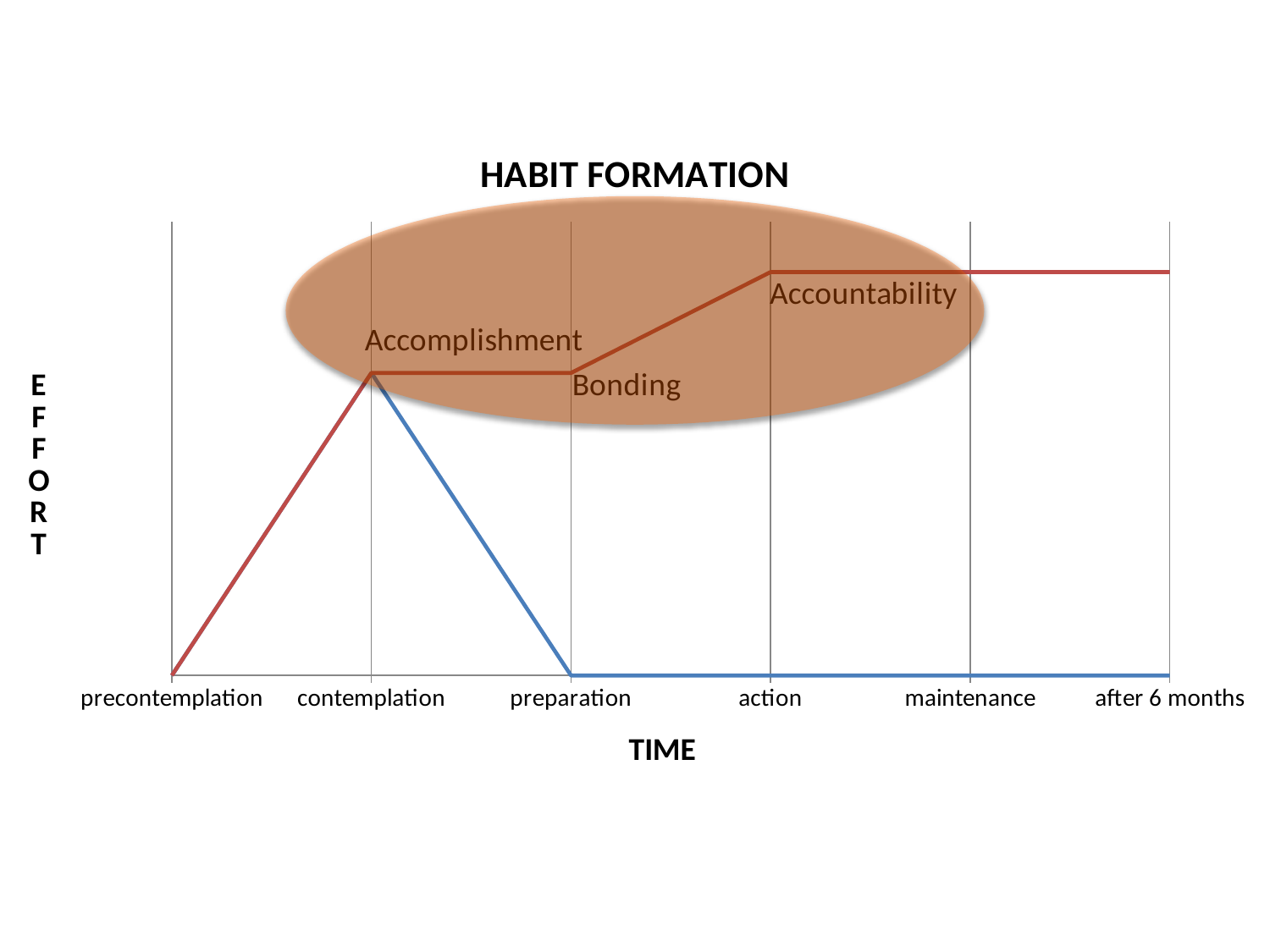
At which category is the red line at its lowest point? precontemplation How many categories are shown on the x axis? 6 At which category does the blue line reach its highest point? contemplation Which is the last category on the x axis? after 6 months Does the red line rise or fall between precontemplation and contemplation? rise How many lines are plotted on the chart? 2 What is the label of the vertical axis? EFFORT Does the red line rise or fall between preparation and action? rise At preparation, which line is higher, the red line or the blue line? red line What is the title of the chart? HABIT FORMATION What kind of chart is shown on the slide? line chart Does the blue line rise or fall between contemplation and preparation? fall